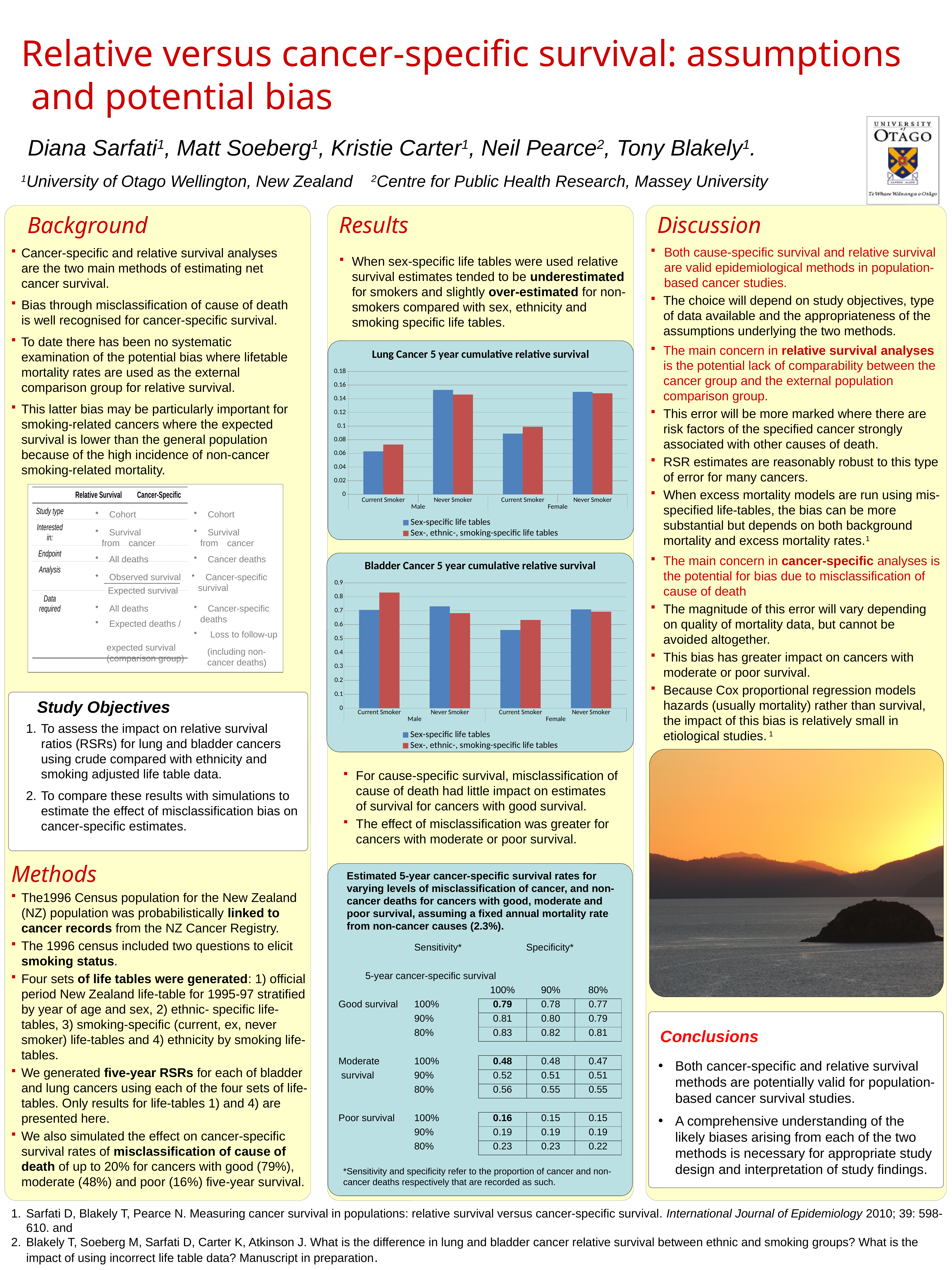
How many series does the legend of the Bladder Cancer 5 year cumulative relative survival chart list? 2 What colour are the Sex-, ethnic-, smoking-specific life tables bars in the Bladder Cancer 5 year cumulative relative survival chart? red In the Bladder Cancer 5 year cumulative relative survival chart, is the Sex-specific life tables value for Female Current Smoker greater or less than 0.6? less In the Lung Cancer 5 year cumulative relative survival chart, is the Sex-specific life tables value for Male Never Smoker greater or less than 0.14? greater In the Lung Cancer 5 year cumulative relative survival chart, for Female Current Smoker, which series has the larger value: Sex-specific life tables or Sex-, ethnic-, smoking-specific life tables? Sex-, ethnic-, smoking-specific life tables In the Lung Cancer 5 year cumulative relative survival chart, is the Sex-specific life tables value for Male Current Smoker greater or less than 0.08? less In the Lung Cancer 5 year cumulative relative survival chart, which category has the lowest Sex-specific life tables value? Male Current Smoker What kind of chart is the Lung Cancer 5 year cumulative relative survival chart? bar chart In the Bladder Cancer 5 year cumulative relative survival chart, for Male Never Smoker, which series has the larger value: Sex-specific life tables or Sex-, ethnic-, smoking-specific life tables? Sex-specific life tables In the Bladder Cancer 5 year cumulative relative survival chart, which category has the lowest Sex-specific life tables value? Female Current Smoker How many categories are shown along the x axis of the Lung Cancer 5 year cumulative relative survival chart? 4